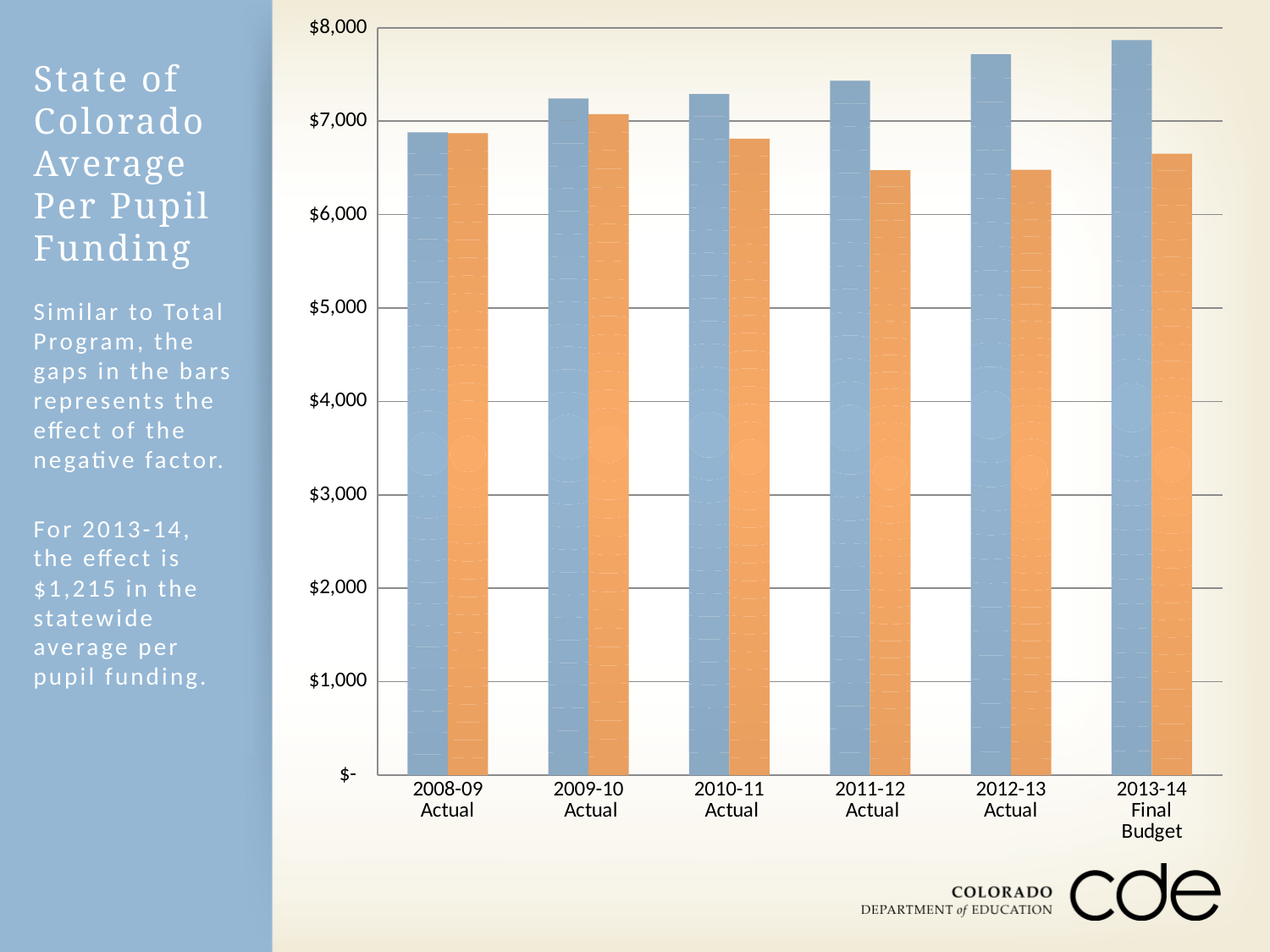
Is the value of the blue bar for 2013-14 Final Budget greater or less than $7,000? greater What is the title of the slide containing the chart? State of Colorado Average Per Pupil Funding Is the value of the orange bar for 2011-12 Actual greater or less than $7,000? less Is the value of the orange bar for 2013-14 Final Budget greater or less than $6,000? greater How many year categories are shown on the x axis? 6 What kind of chart is shown on the slide? bar chart In which year category is the blue bar the shortest? 2008-09 Actual How many bars are plotted for each year category? 2 For 2011-12 Actual, which bar is taller, the blue bar or the orange bar? the blue bar In which year category is the blue bar the tallest? 2013-14 Final Budget Do the blue bars rise or fall from 2008-09 to 2013-14? rise